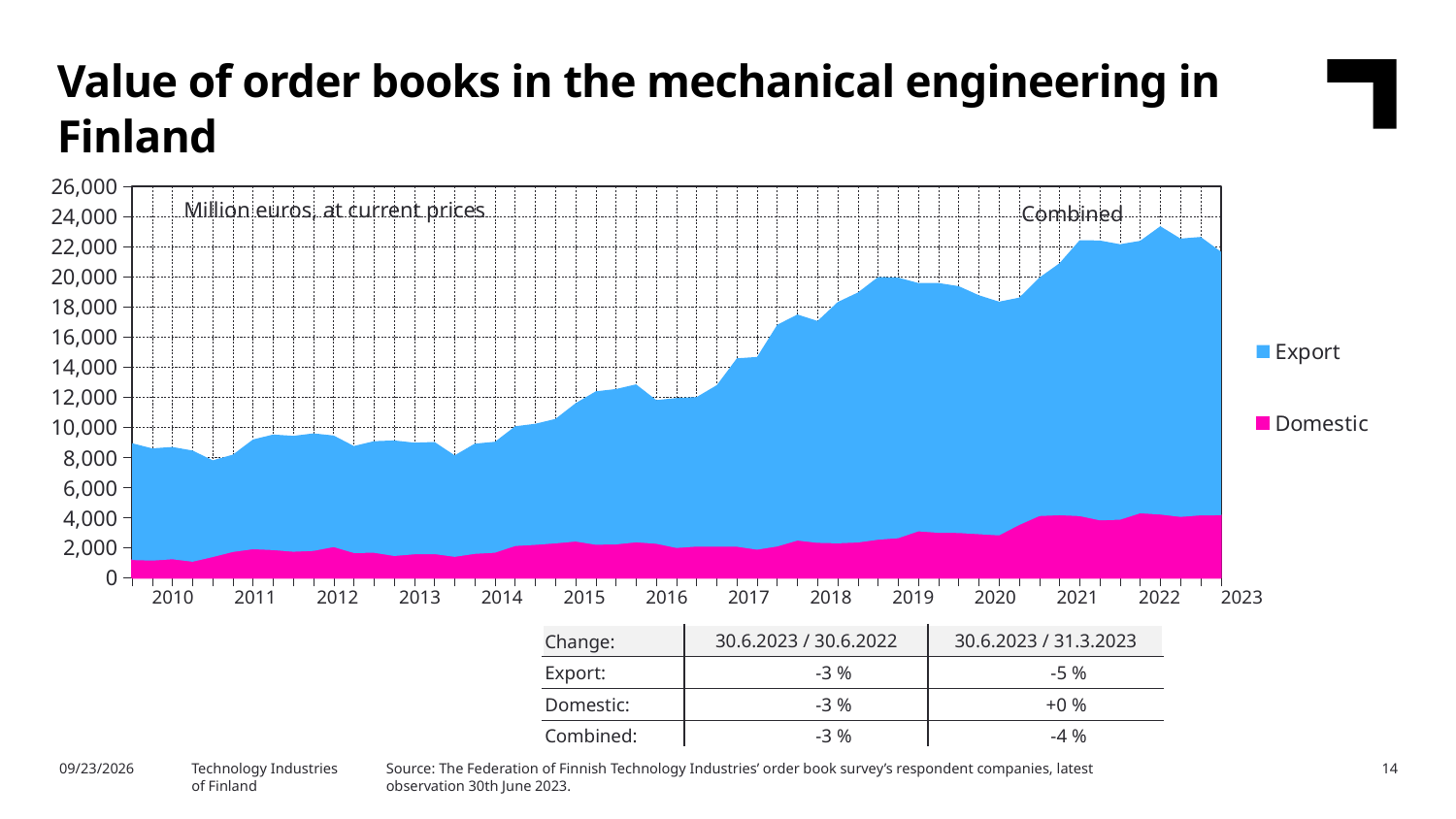
Which two series are listed in the chart's legend? Export and Domestic What kind of chart is shown on the slide? Stacked area chart Is the combined value of order books at the end of the series (mid-2023) greater or less than 20,000? greater How many series does the chart's legend list? 2 Is the Domestic value at the start of 2010 greater or less than 2,000? less Is the combined value of order books in 2020 greater or less than 16,000? greater In which year does the combined value of order books reach its highest point? 2022 Which series is larger throughout the chart, Export or Domestic? Export Does the combined value of order books generally rise or fall from 2010 to 2023? rise What unit is stated for the values in the chart? Million euros, at current prices